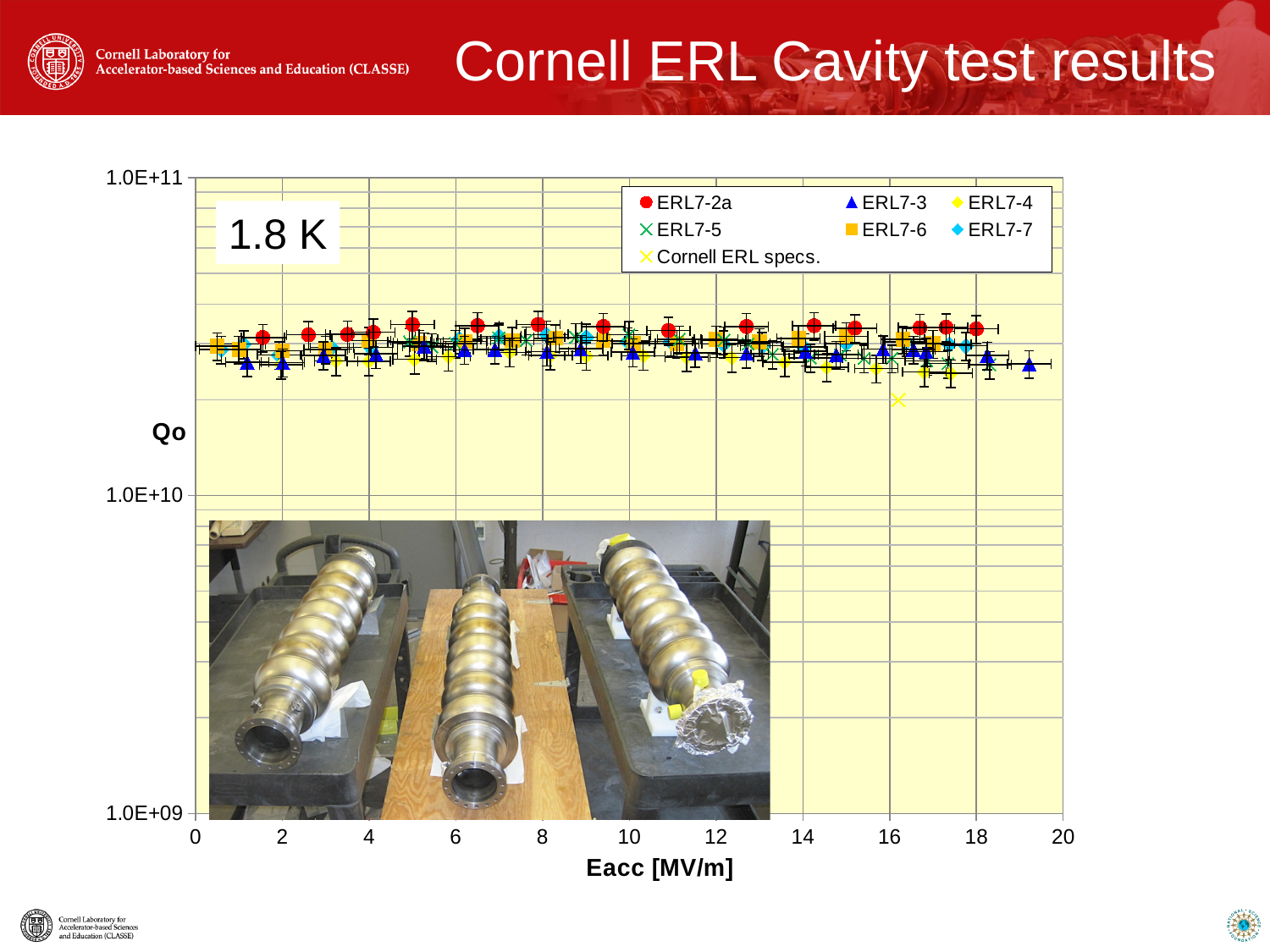
Are the Qo values for ERL7-3 greater or less than 1.0E+11? less What is the title of the slide's chart? Cornell ERL Cavity test results Which series has higher Qo values, ERL7-2a or ERL7-3? ERL7-2a Is the Qo value for the Cornell ERL specs point greater or less than 1.0E+11? less What is the label of the x axis? Eacc [MV/m] Which series has the highest Qo values on the chart? ERL7-2a Is the Cornell ERL specs point plotted at an Eacc greater or less than 14 MV/m? greater Which legend entry has the lowest plotted point on the chart? Cornell ERL specs. What kind of chart is shown on the slide? scatter chart How many series does the legend list? 7